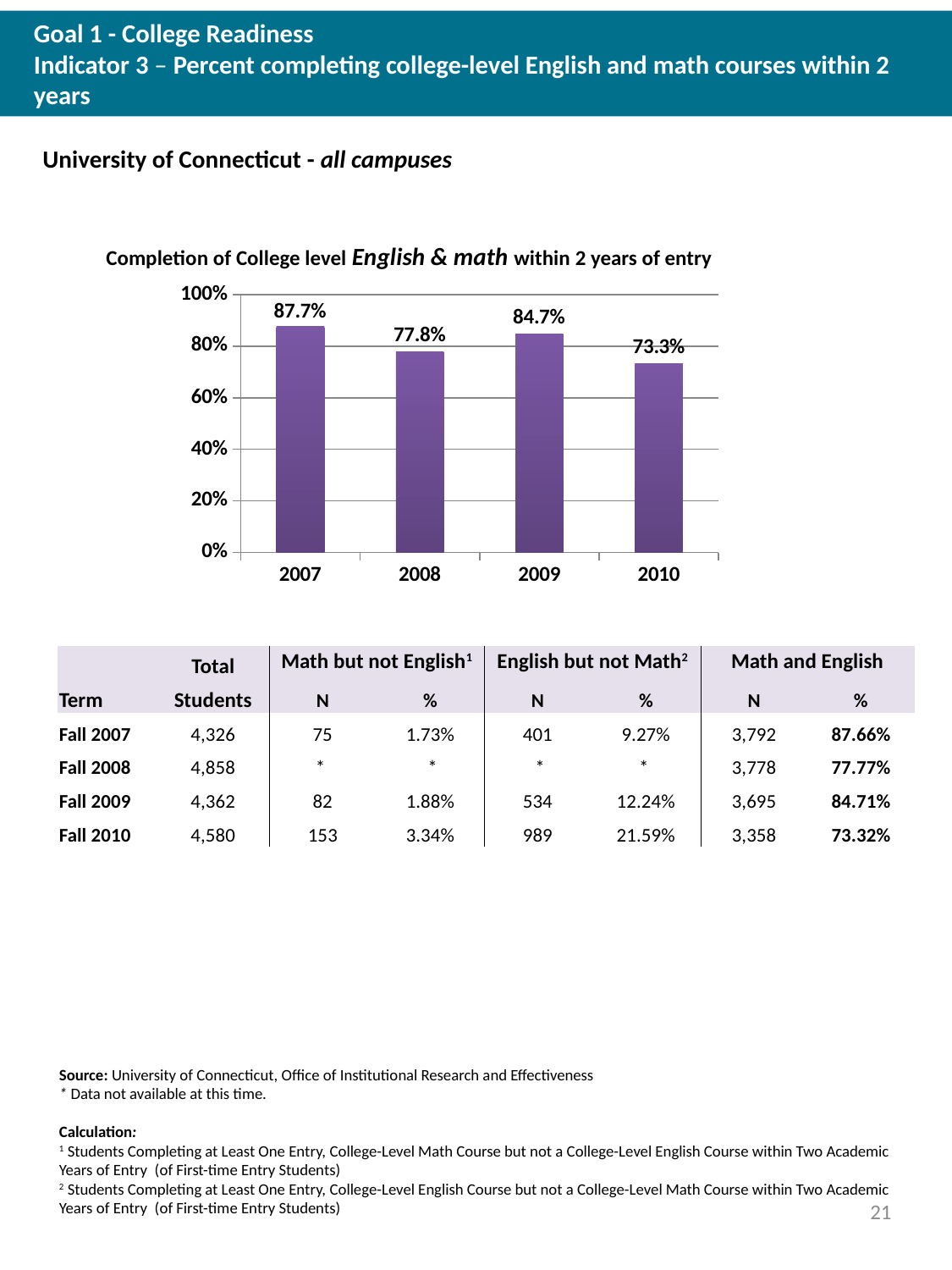
What kind of chart is shown? bar chart Which year has the highest value? 2007 What is the value for 2010? 73.3% What is the value for 2007? 87.7% Which is larger, the value for 2008 or the value for 2009? 2009 What is the difference between the values for 2009 and 2008? 6.9% How many years are shown on the x axis? 4 What is the value for 2009? 84.7% What is the title of the chart? Completion of College level English & math within 2 years of entry Which year has the lowest value? 2010 What is the difference between the values for 2007 and 2010? 14.4% Is the value for 2008 greater or less than 80%? less